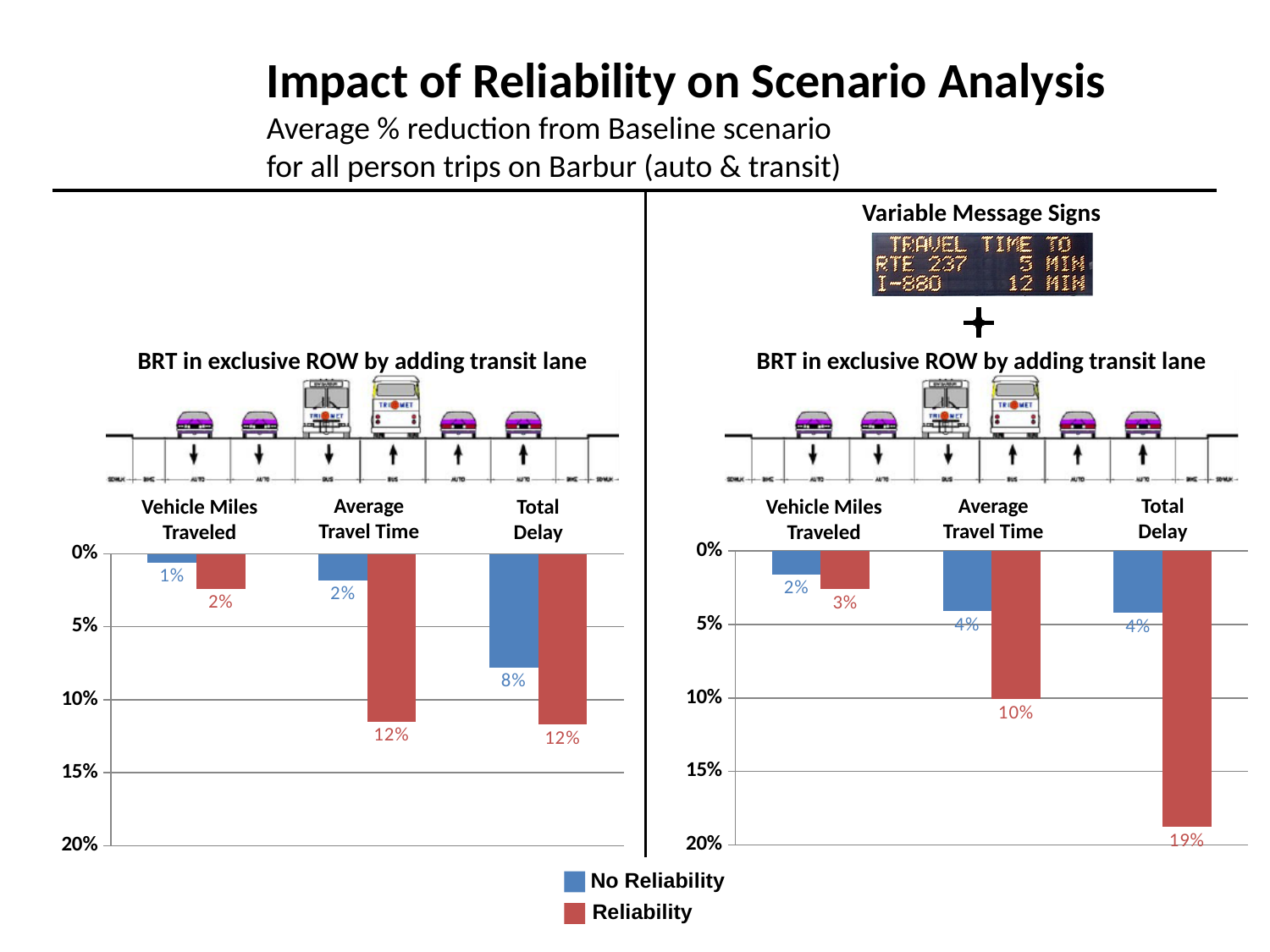
What type of chart is the right chart? Bar chart In the left chart, which category has the smallest No Reliability value? Vehicle Miles Traveled In the right chart, what is the No Reliability value for Vehicle Miles Traveled? 2% In the left chart, what is the No Reliability value for Total Delay? 8% How many categories are shown on the x axis of the left chart? 3 How many series does the legend list? 2 In the right chart, which is larger for Average Travel Time: the Reliability value or the No Reliability value? Reliability In the left chart, what is the difference between the Reliability and No Reliability values for Average Travel Time? 10% In the left chart, what is the Reliability value for Average Travel Time? 12% In the right chart, what is the Reliability value for Total Delay? 19% In the right chart, which category has the largest Reliability value? Total Delay In the right chart, what is the difference between the Reliability and No Reliability values for Total Delay? 15%